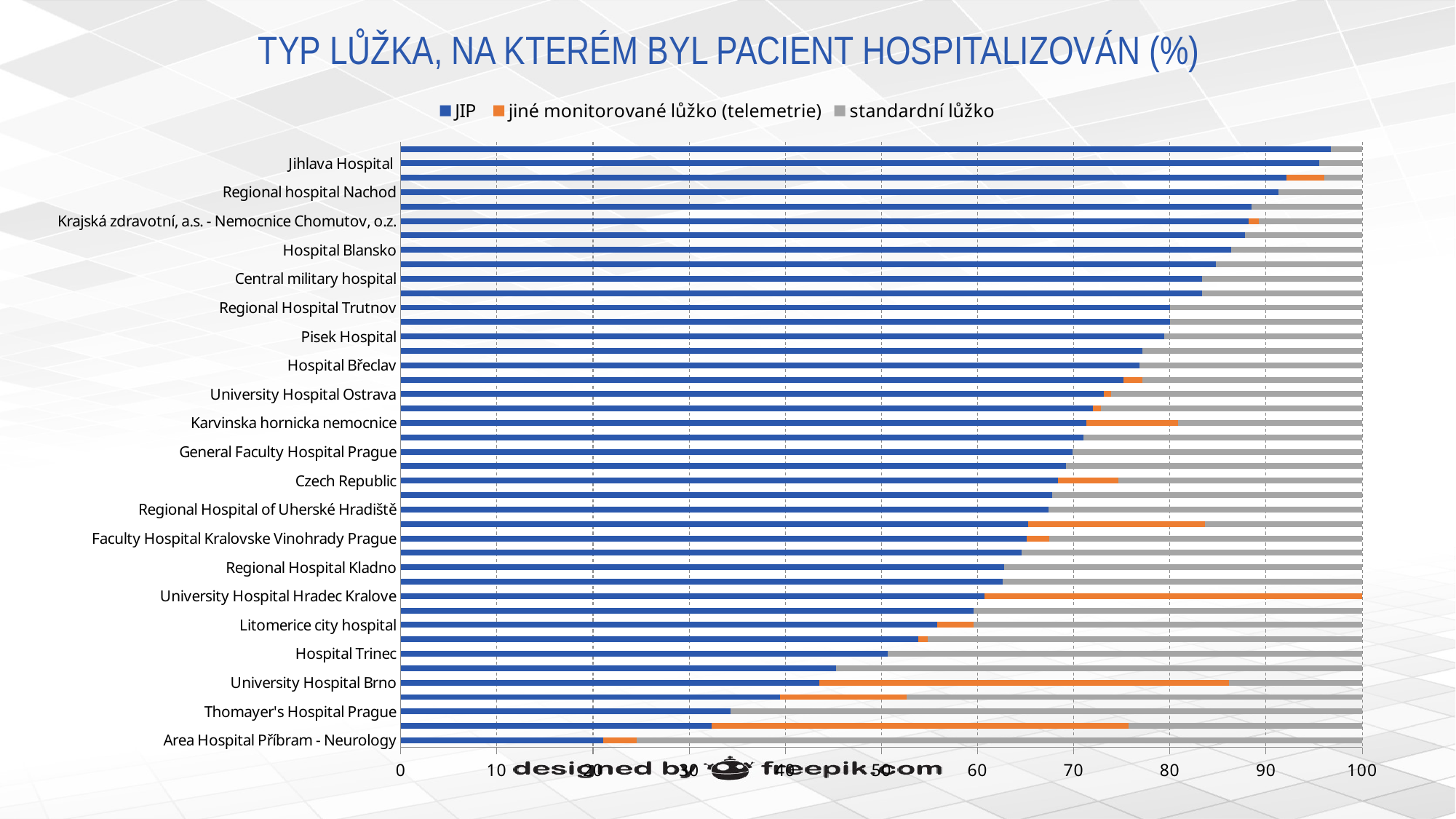
Which has a larger JIP value, Hospital Trinec or Regional Hospital Trutnov? Regional Hospital Trutnov Which has a larger JIP value, Jihlava Hospital or Thomayer's Hospital Prague? Jihlava Hospital Is the JIP value for Regional Hospital Trutnov greater or less than 70? greater Which colour represents the JIP series in the chart? Blue Is the JIP value for Thomayer's Hospital Prague greater or less than 40? less Is the JIP value for Hospital Trinec greater or less than 60? less How many series does the legend list? 3 Which labelled hospital has the lowest JIP value? Area Hospital Příbram - Neurology What kind of chart is shown on the slide? Stacked bar chart What is the title of the chart? TYP LŮŽKA, NA KTERÉM BYL PACIENT HOSPITALIZOVÁN (%)